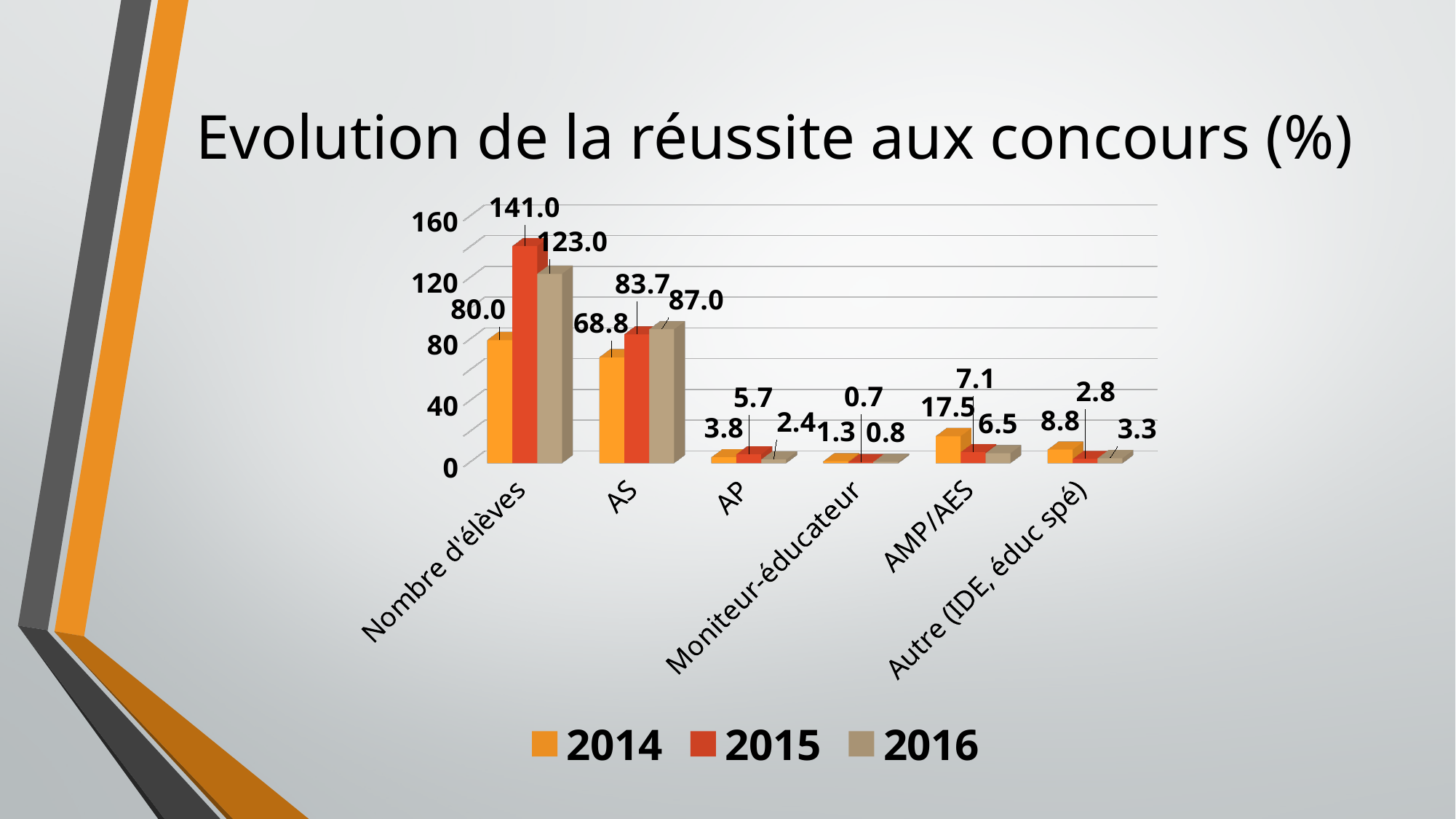
Which is larger for AP: the 2014 value or the 2015 value? 2015 What kind of chart is shown on the slide? Bar chart Which category has the lowest value in 2016? Moniteur-éducateur What is the value for AMP/AES in 2014? 17.5 What is the title of the chart? Evolution de la réussite aux concours (%) Which category has the highest value in 2014? Nombre d'élèves How many series does the legend list? 3 What is the value for Moniteur-éducateur in 2015? 0.7 What is the difference between the 2015 and 2014 values for Nombre d'élèves? 61.0 What is the value for AS in 2016? 87.0 How many categories are shown on the x axis? 6 What is the value for Nombre d'élèves in 2015? 141.0